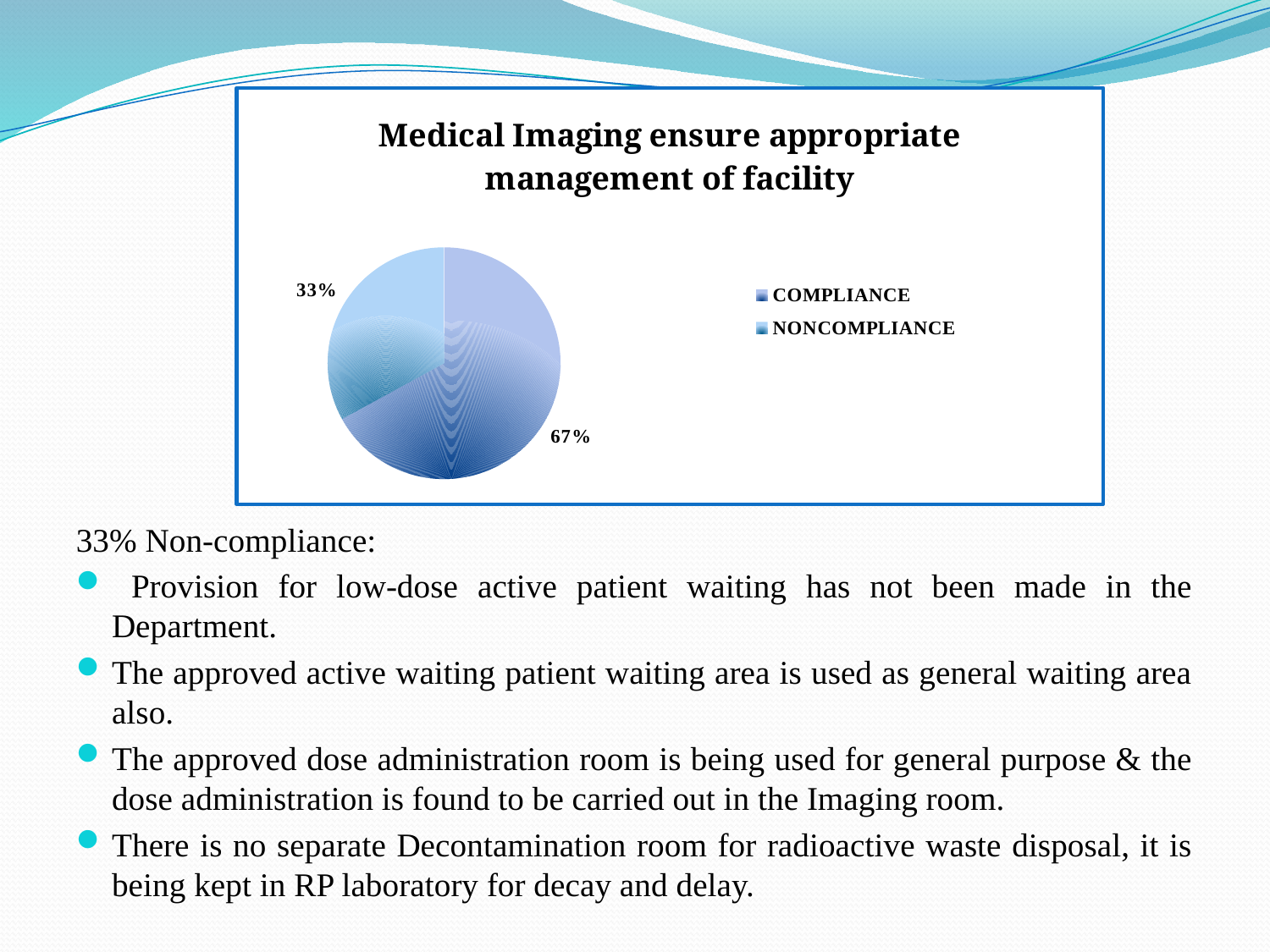
Is the NONCOMPLIANCE share greater or less than 50%? less What is the title of the chart? Medical Imaging ensure appropriate management of facility What share of the pie is COMPLIANCE? 67% Which is larger, the COMPLIANCE slice or the NONCOMPLIANCE slice? COMPLIANCE What share of the pie is NONCOMPLIANCE? 33% What are the two legend entries of the chart? COMPLIANCE and NONCOMPLIANCE Which category has the largest slice of the pie? COMPLIANCE What kind of chart is shown on the slide? Pie chart How many entries does the legend list? 2 How many slices does the pie chart have? 2 What is the difference in percentage points between the COMPLIANCE and NONCOMPLIANCE slices? 34 Which category has the smallest slice of the pie? NONCOMPLIANCE